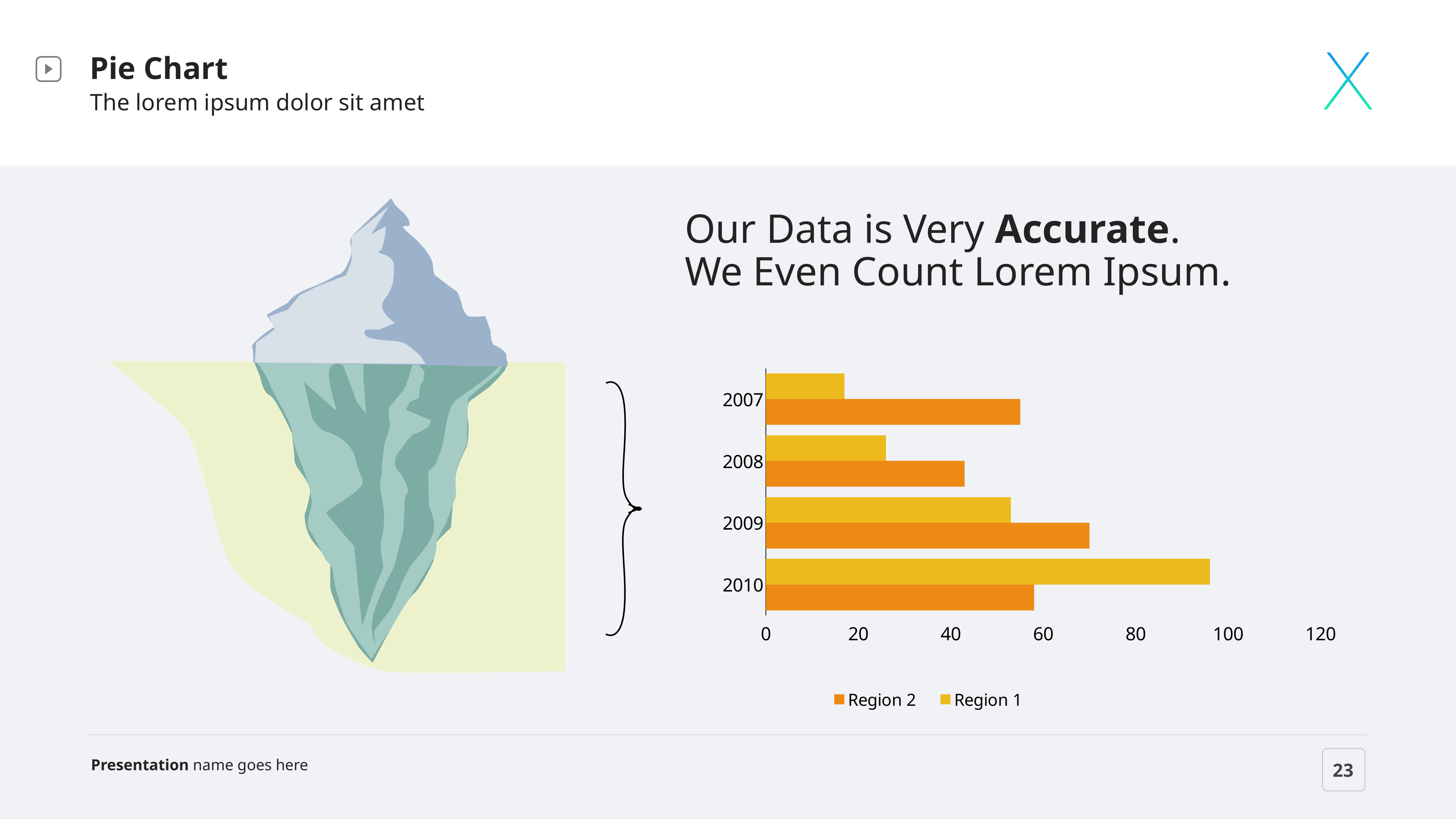
Is the value for Region 1 in 2010 greater or less than 80? greater In 2010, which series has the larger value, Region 1 or Region 2? Region 1 In 2007, which series has the larger value, Region 1 or Region 2? Region 2 What kind of chart is shown on the slide? Bar chart Which year has the lowest value for Region 1? 2007 How many years are shown on the chart's vertical axis? 4 Which year has the highest value for Region 1? 2010 Which year has the lowest value for Region 2? 2008 Which year has the highest value for Region 2? 2009 How many series does the chart legend list? 2 Is the value for Region 1 in 2007 greater or less than 20? less Do the Region 1 values rise or fall from 2007 to 2010? rise